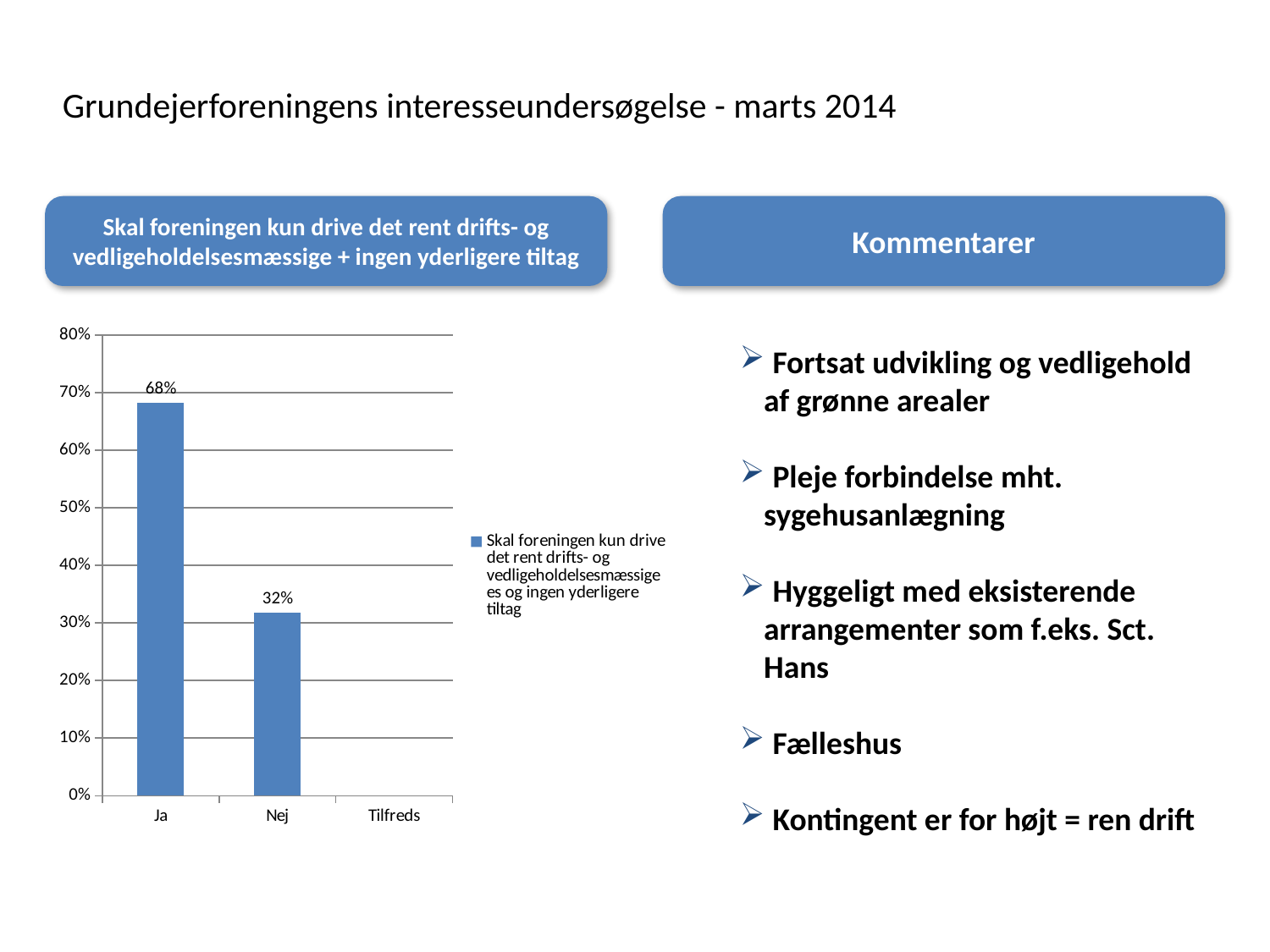
Which is larger, the value for Ja or the value for Nej? Ja How many categories are shown on the x axis? 3 What is the value for Ja? 68% Is the value for Nej greater or less than 40%? less Which category has the highest value? Ja What kind of chart is shown on the slide? Bar chart What is the highest value shown on the y axis? 80% What is the value for Nej? 32% How many series does the legend list? 1 Is the value for Ja greater or less than 60%? greater What is the difference between the values for Ja and Nej? 36% Which category on the x axis has no visible bar? Tilfreds